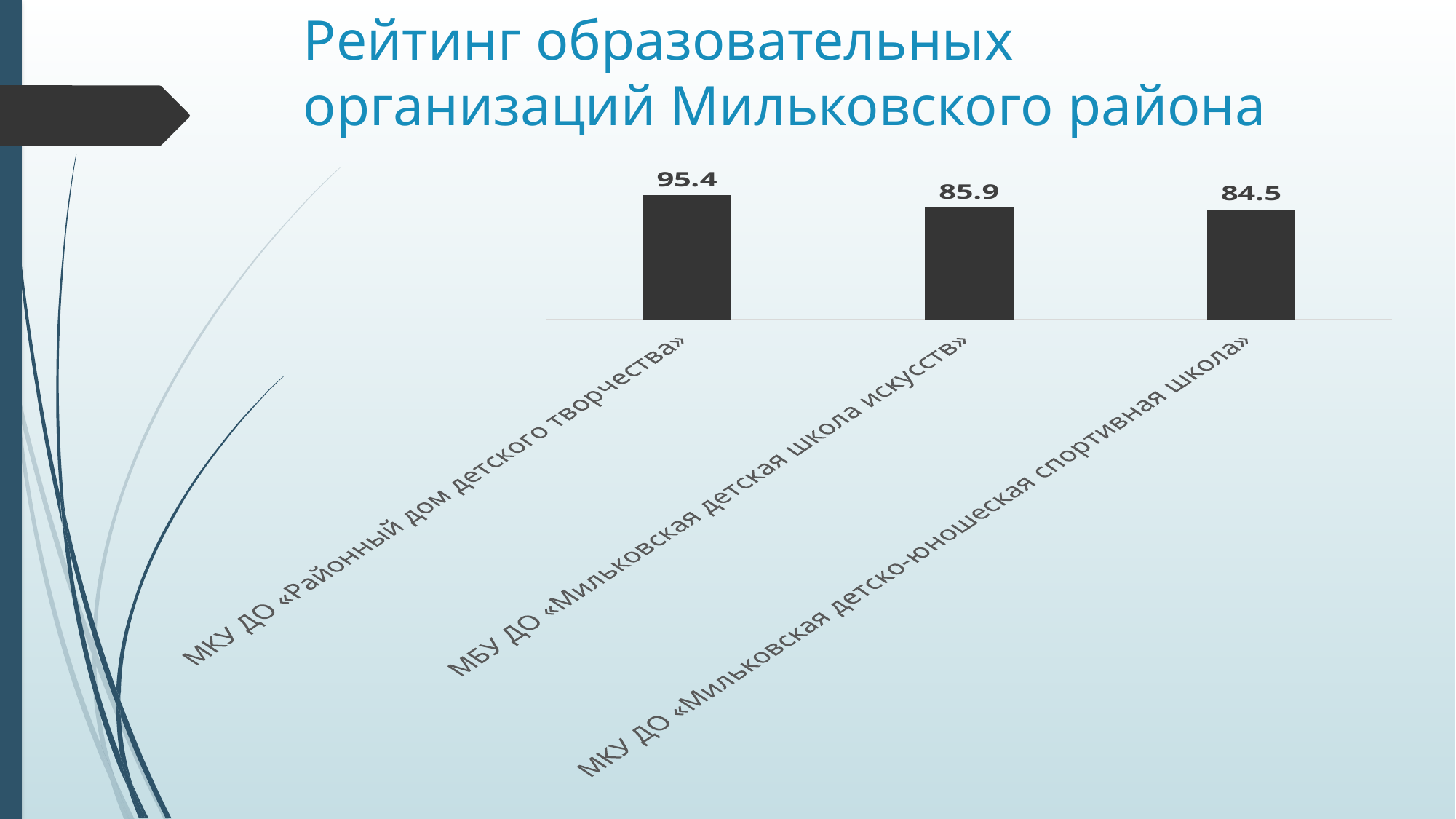
Do the values rise or fall from left to right across the chart? Fall What is the value for МКУ ДО «Районный дом детского творчества»? 95.4 How many organisations are shown in the chart? 3 What is the value for МКУ ДО «Мильковская детско-юношеская спортивная школа»? 84.5 What is the value for МБУ ДО «Мильковская детская школа искусств»? 85.9 What is the difference between the values for МКУ ДО «Районный дом детского творчества» and МБУ ДО «Мильковская детская школа искусств»? 9.5 What kind of chart is shown on the slide? Bar chart Which organisation has the highest value? МКУ ДО «Районный дом детского творчества» What is the difference between the values for МБУ ДО «Мильковская детская школа искусств» and МКУ ДО «Мильковская детско-юношеская спортивная школа»? 1.4 Which is larger: the value for МКУ ДО «Районный дом детского творчества» or the value for МКУ ДО «Мильковская детско-юношеская спортивная школа»? МКУ ДО «Районный дом детского творчества» What is the title of the slide? Рейтинг образовательных организаций Мильковского района Which organisation has the lowest value? МКУ ДО «Мильковская детско-юношеская спортивная школа»